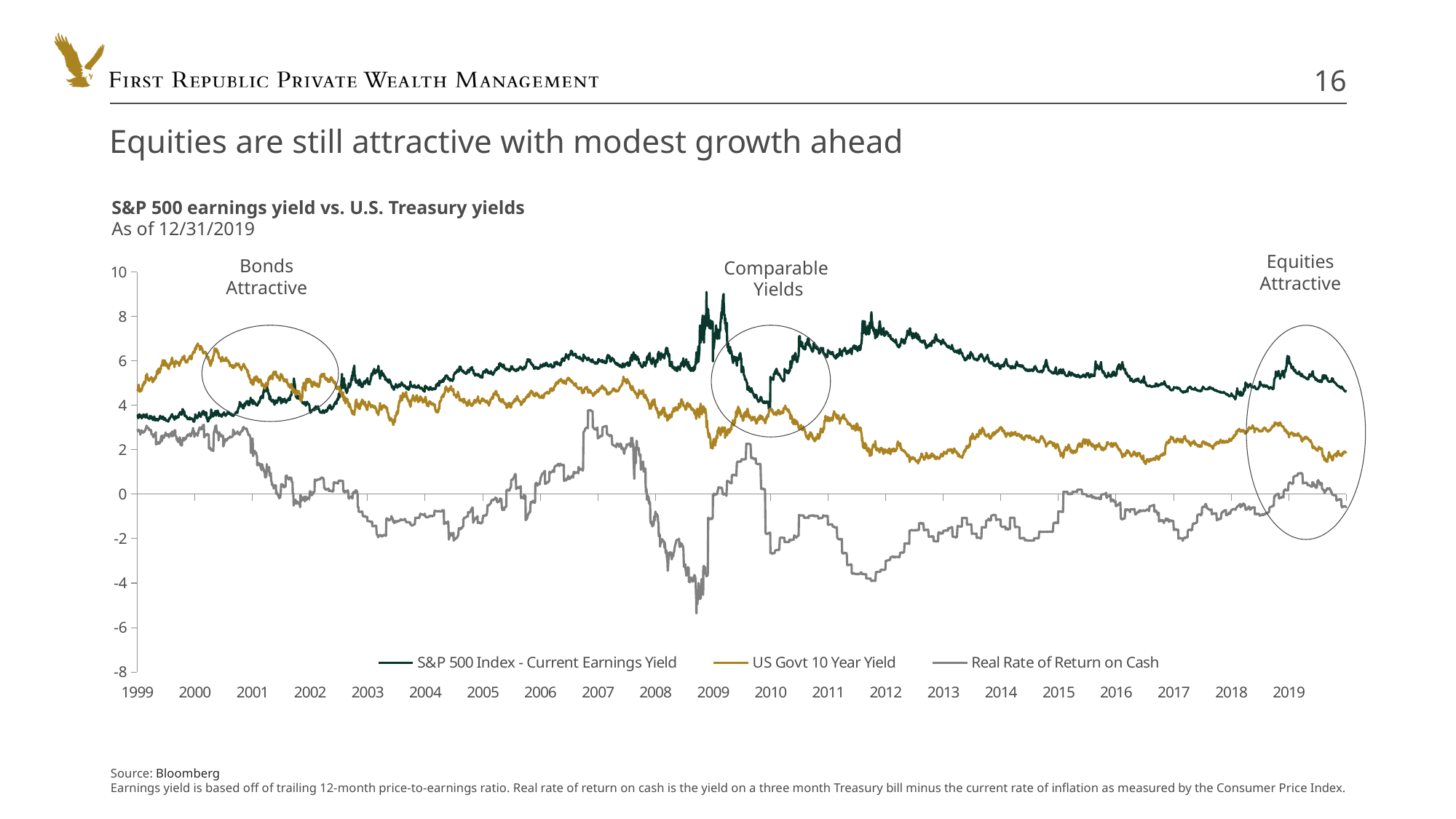
In 2000, which is higher: the US Govt 10 Year Yield or the S&P 500 Index - Current Earnings Yield? US Govt 10 Year Yield What kind of chart is shown on the slide? Line chart Is the value of the US Govt 10 Year Yield at the end of 2019 greater or less than 4? less Is the value of the S&P 500 Index - Current Earnings Yield at the end of 2019 greater or less than 4? greater Is the peak of the US Govt 10 Year Yield around 2000 greater or less than 6? greater What are the three annotation labels placed above the circled regions of the chart, from left to right? Bonds Attractive, Comparable Yields, Equities Attractive Overall, does the US Govt 10 Year Yield rise or fall from 1999 to 2019? Fall How many series does the legend list? 3 In 2019, which is higher: the S&P 500 Index - Current Earnings Yield or the US Govt 10 Year Yield? S&P 500 Index - Current Earnings Yield What is the title of the chart? S&P 500 earnings yield vs. U.S. Treasury yields How many year labels are shown on the x axis? 21